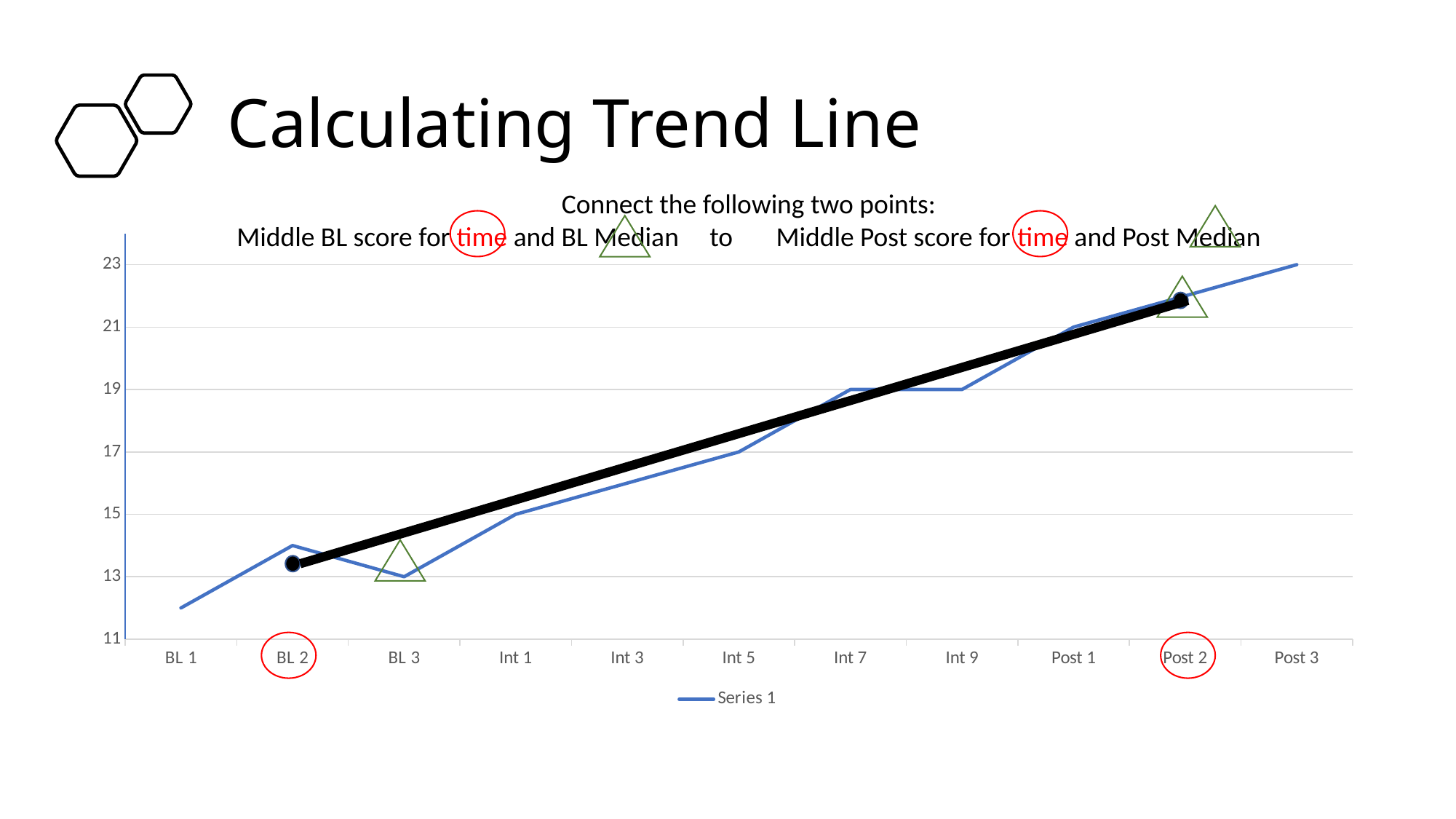
Is the value for BL 2 greater or less than 13? greater Which category has the highest value for Series 1? Post 3 Do the values generally rise or fall from BL 1 to Post 3? rise How many categories are shown on the x axis? 11 What is the value for Post 3? 23 What is the name of the series in the legend? Series 1 How many series does the legend list? 1 What is the value for Int 7? 19 Which is larger, the value for Int 1 or the value for Int 5? Int 5 Which category has the lowest value for Series 1? BL 1 What kind of chart is shown on the slide? line chart What is the value for BL 3? 13